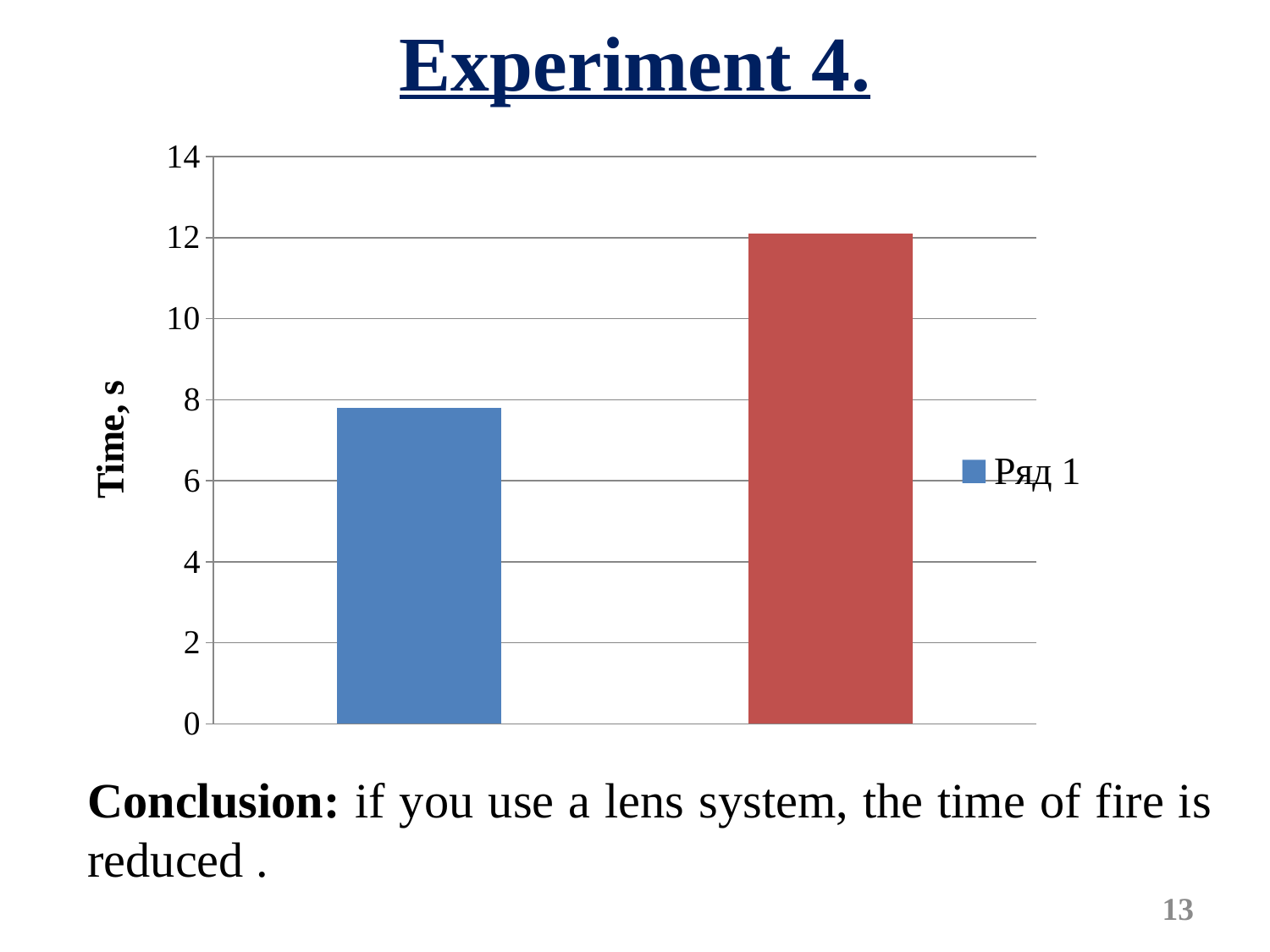
Is the value of the blue bar on the left greater or less than 6? greater What entry is shown in the chart legend? Ряд 1 Is the value of the red bar on the right greater or less than 10? greater Which bar shows the highest value? the red bar on the right How many bars are plotted in the chart? 2 What is the label of the vertical axis? Time, s Is the value of the blue bar on the left greater or less than 8? less How many series does the legend list? 1 Which bar shows the lowest value? the blue bar on the left What kind of chart is shown on the slide? bar chart Which bar is taller, the blue bar on the left or the red bar on the right? the red bar on the right